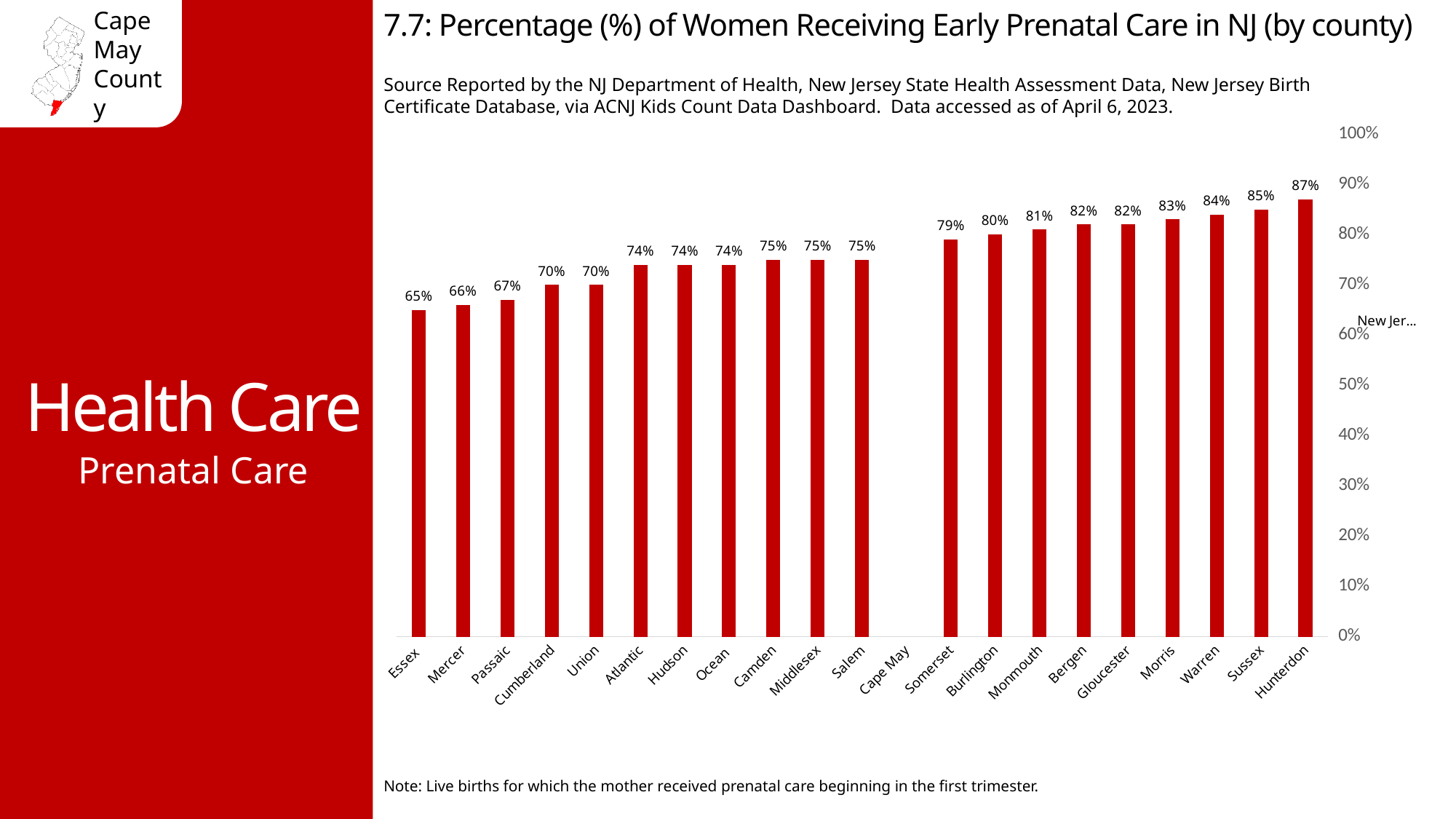
What is the value for Hunterdon? 87% What is the value for Bergen? 82% What is the value for Somerset? 79% Which county has the lowest percentage of women receiving early prenatal care? Essex How many counties are labeled on the x axis? 21 What is the value for Essex? 65% Is the value for Sussex greater or less than 80%? greater Which county has the highest percentage of women receiving early prenatal care? Hunterdon What kind of chart is shown on the slide? bar chart What is the difference between the values for Hunterdon and Essex? 22% Do the values generally rise or fall from left to right along the x axis? rise Which is larger, the value for Morris or the value for Passaic? Morris